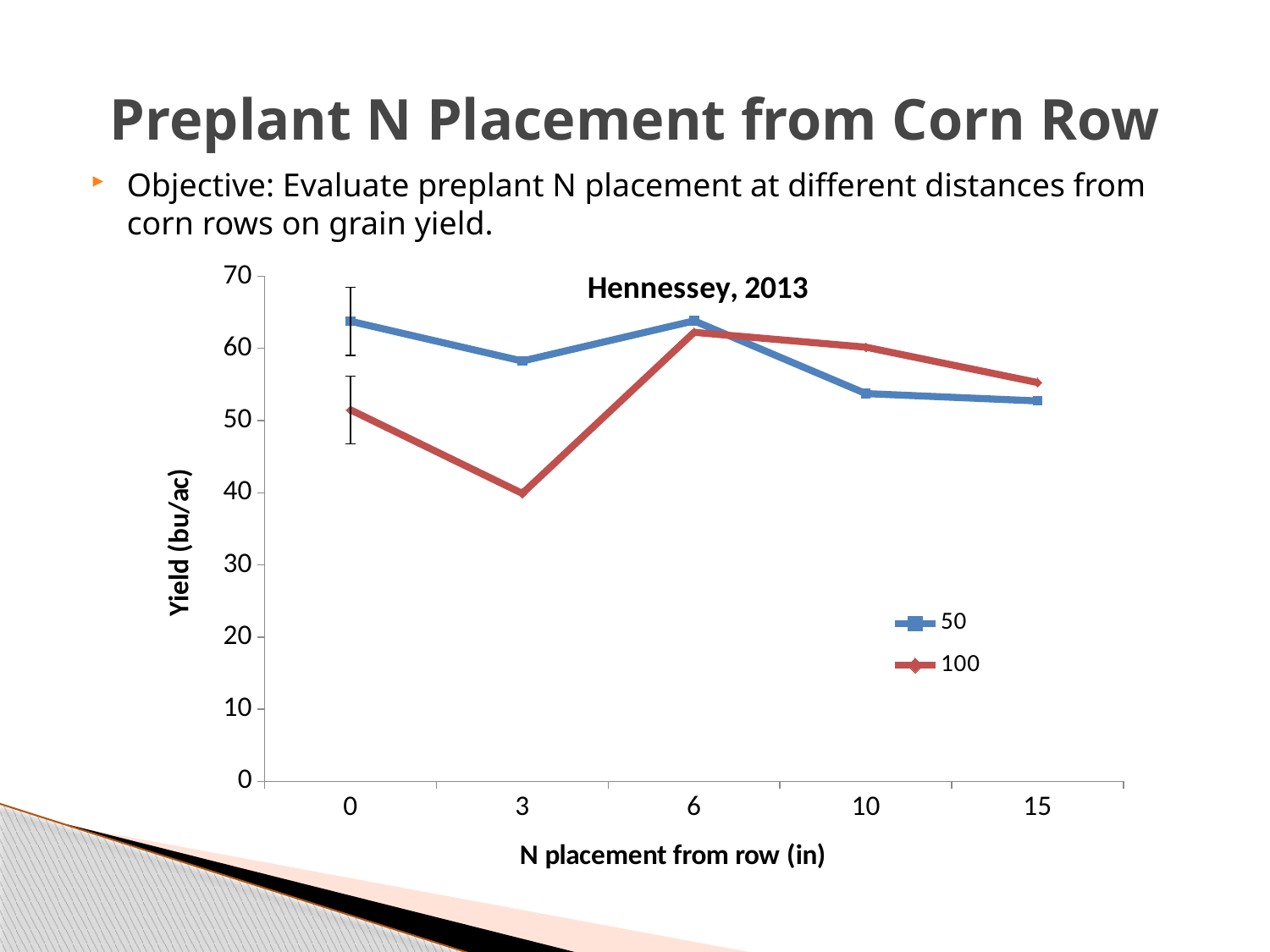
What kind of chart is shown on the slide? Line chart At which N placement distance does the 100 series reach its highest yield? 6 What is the title of the chart? Hennessey, 2013 At which N placement distance does the 100 series have its lowest yield? 3 Is the yield for the 100 series at 3 in greater or less than 50? less At 3 in from the row, which series has the higher yield, 50 or 100? 50 What is the label of the y axis? Yield (bu/ac) Is the yield for the 50 series at 0 in greater or less than 60? greater How many series does the chart legend list? 2 At 10 in from the row, which series has the higher yield, 50 or 100? 100 How many N placement distances are plotted along the x axis? 5 Is the yield for the 100 series at 10 in greater or less than 50? greater